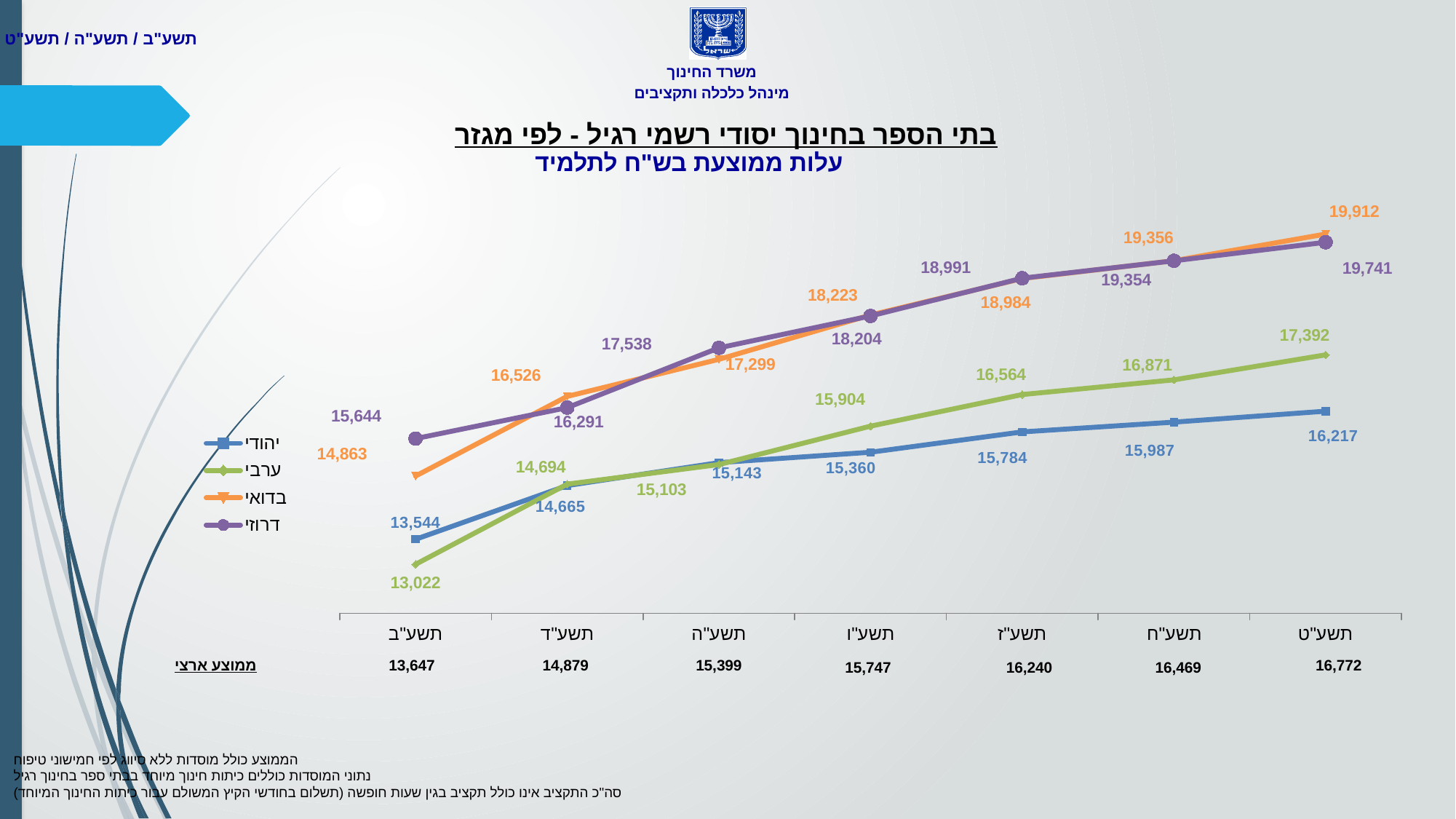
Which series has the highest value in תשע"ט? בדואי What is the value for the ערבי series in תשע"ז? 16,564 How many series does the legend list? 4 How many years are shown on the x axis? 7 What is the value for the דרוזי series in תשע"ה? 17,538 Which is larger in תשע"ד: the בדואי value or the דרוזי value? בדואי Which series has the lowest value in תשע"ב? ערבי What is the value for the בדואי series in תשע"ט? 19,912 Does the יהודי series rise or fall from תשע"ב to תשע"ט? rise What type of chart is shown on the slide? line chart What is the difference between the ערבי and יהודי values in תשע"ט? 1,175 What is the value for the יהודי series in תשע"ב? 13,544